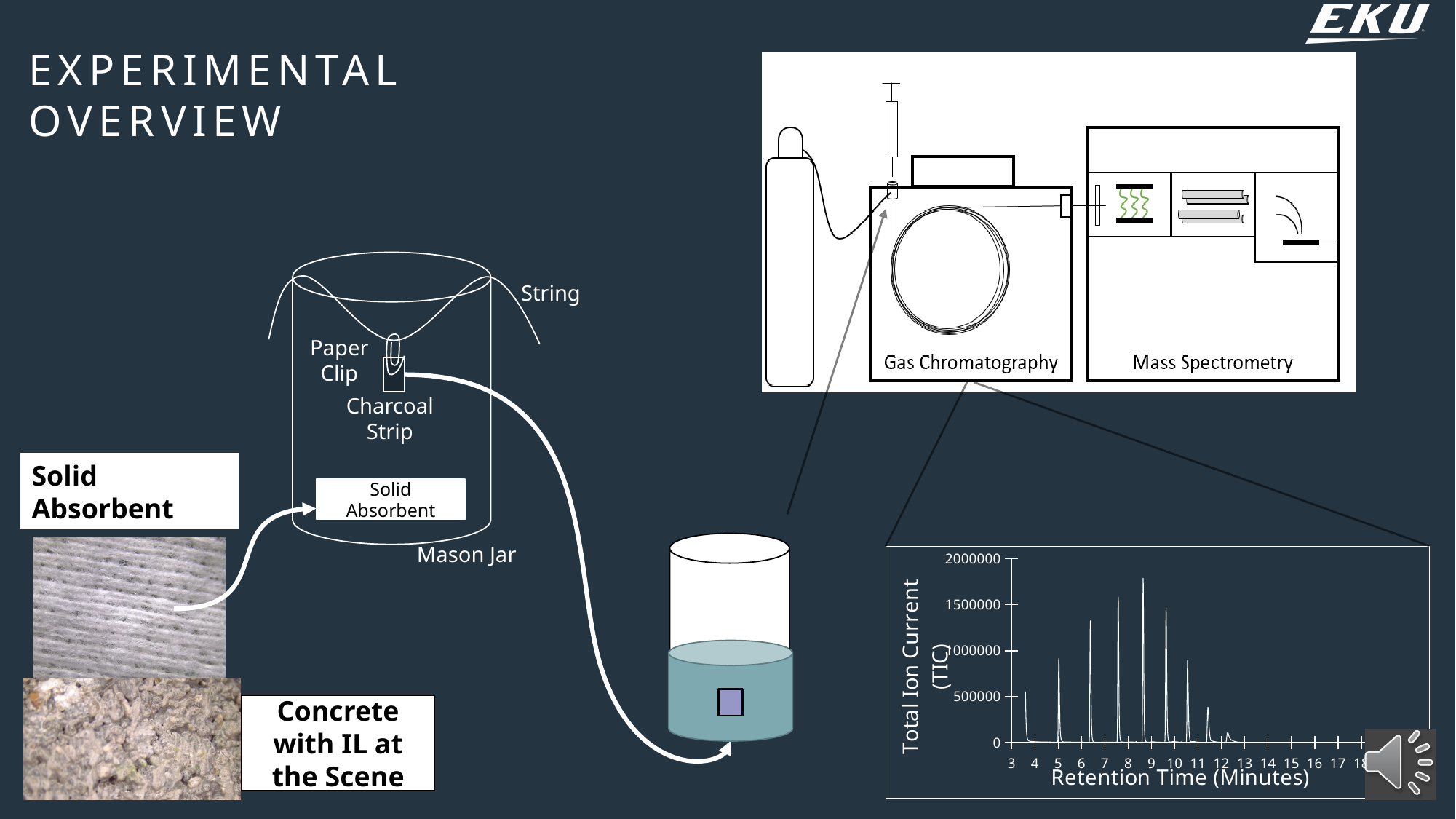
In the chromatogram chart, is the peak between 6 and 7 minutes greater or less than 1000000? greater In the chromatogram chart, is the peak near 5 minutes greater or less than 1000000? less In the chromatogram chart, is the first peak (between 3 and 4 minutes) greater or less than 1000000? less In the chromatogram chart, between which two labelled x-axis ticks does the tallest peak occur? 8 and 9 In the chromatogram chart, which peak is taller: the one between 5 and 6 minutes or the one between 7 and 8 minutes? the one between 7 and 8 minutes What is the y-axis label of the chart at the bottom right? Total Ion Current (TIC) In the chromatogram chart, which peak is taller: the one between 8 and 9 minutes or the one between 10 and 11 minutes? the one between 8 and 9 minutes What is the x-axis label of the chart at the bottom right? Retention Time (Minutes) How many labelled tick values are shown on the x axis of the chromatogram chart? 16 What kind of chart is shown at the bottom right of the slide? line chart